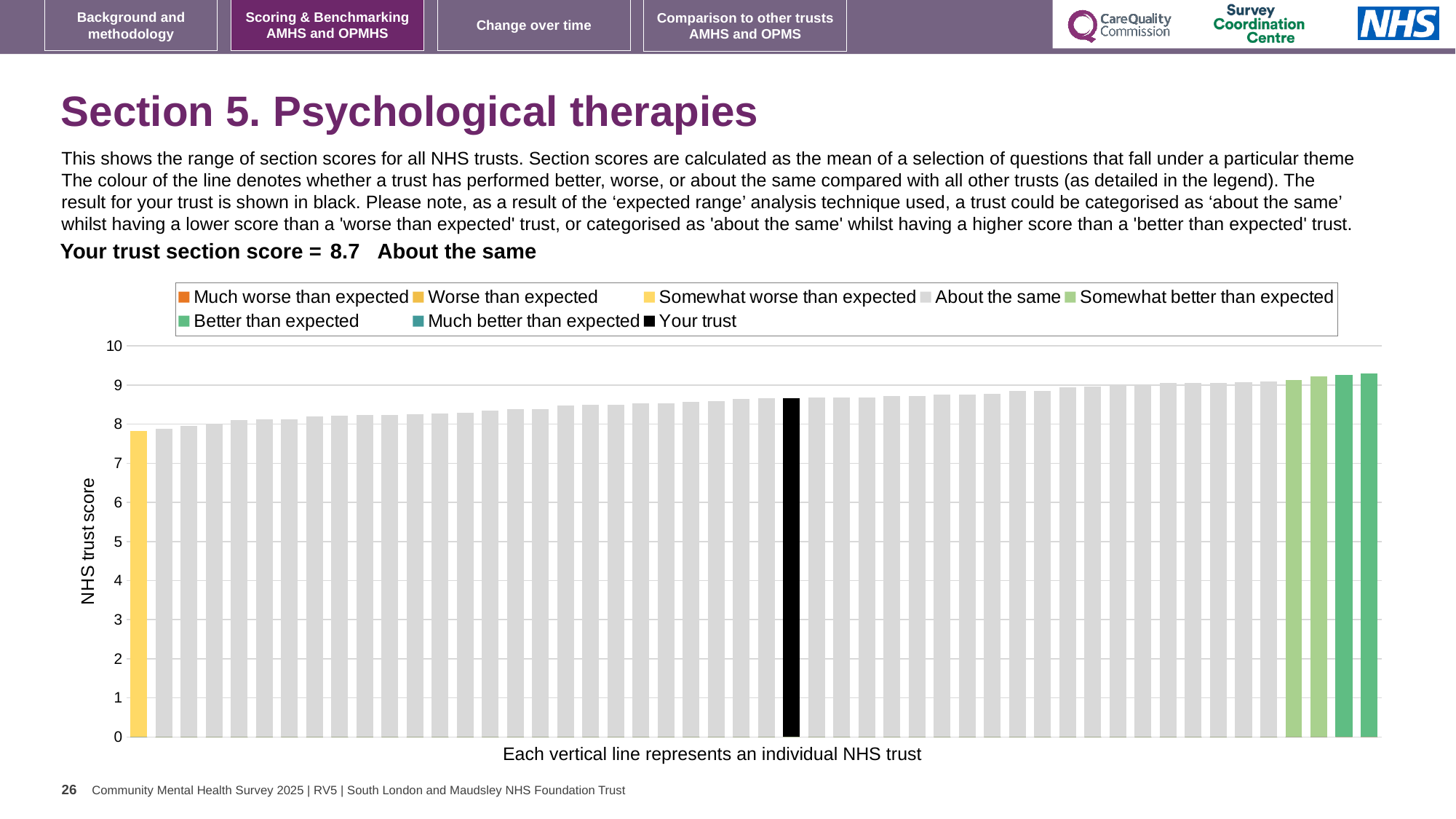
How many bars are coloured yellow (Somewhat worse than expected)? 1 What colour is the bar representing your trust? black Do the bar values rise or fall from left to right along the x axis? rise What kind of chart is shown on the slide? bar chart What is the section score for your trust shown on the slide? 8.7 What is the title of the y axis? NHS trust score How many entries does the chart legend list? 8 Which category is your trust placed in for this section? About the same Is the value for your trust (the black bar) greater or less than 8? greater Is the value of the tallest bar greater or less than 9? greater Is the value of the shortest bar greater or less than 8? less